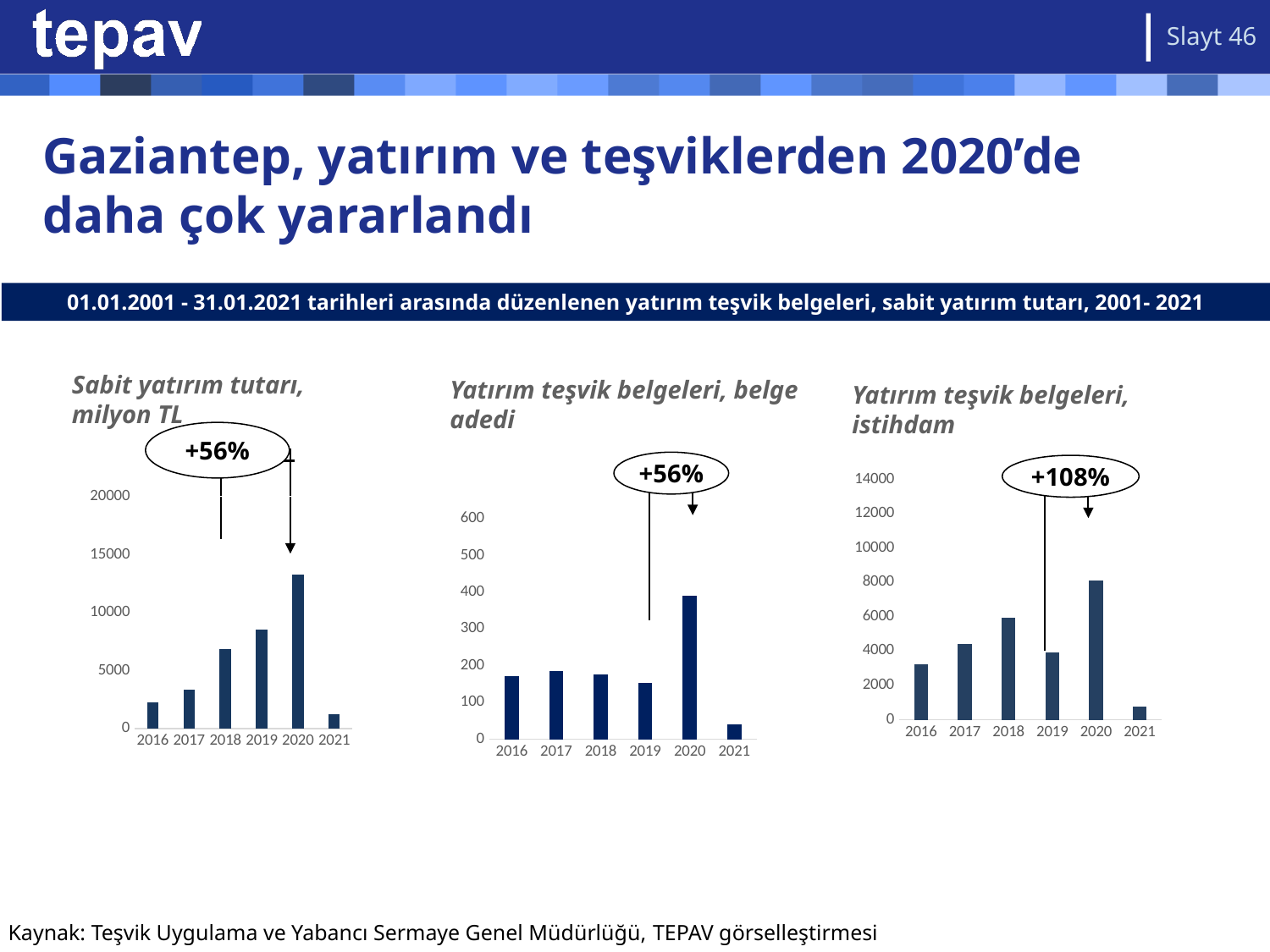
What kind of chart is the 'Sabit yatırım tutarı, milyon TL' chart? bar chart In the 'Yatırım teşvik belgeleri, istihdam' chart, which is larger, the value for 2018 or the value for 2019? 2018 In the 'Sabit yatırım tutarı, milyon TL' chart, is the value for 2020 greater or less than 10000? greater In the 'Sabit yatırım tutarı, milyon TL' chart, do the values rise or fall from 2016 to 2020? rise In the 'Yatırım teşvik belgeleri, belge adedi' chart, is the value for 2019 greater or less than 200? less In the 'Sabit yatırım tutarı, milyon TL' chart, which year has the highest bar? 2020 What percentage change is annotated above the 2020 bar in the 'Yatırım teşvik belgeleri, istihdam' chart? +108% In the 'Yatırım teşvik belgeleri, istihdam' chart, which year has the highest bar? 2020 How many years are shown on the x axis of the 'Yatırım teşvik belgeleri, belge adedi' chart? 6 In the 'Yatırım teşvik belgeleri, istihdam' chart, is the value for 2020 greater or less than 6000? greater In the 'Yatırım teşvik belgeleri, belge adedi' chart, which year has the lowest bar? 2021 In the 'Sabit yatırım tutarı, milyon TL' chart, which is larger, the value for 2017 or the value for 2019? 2019